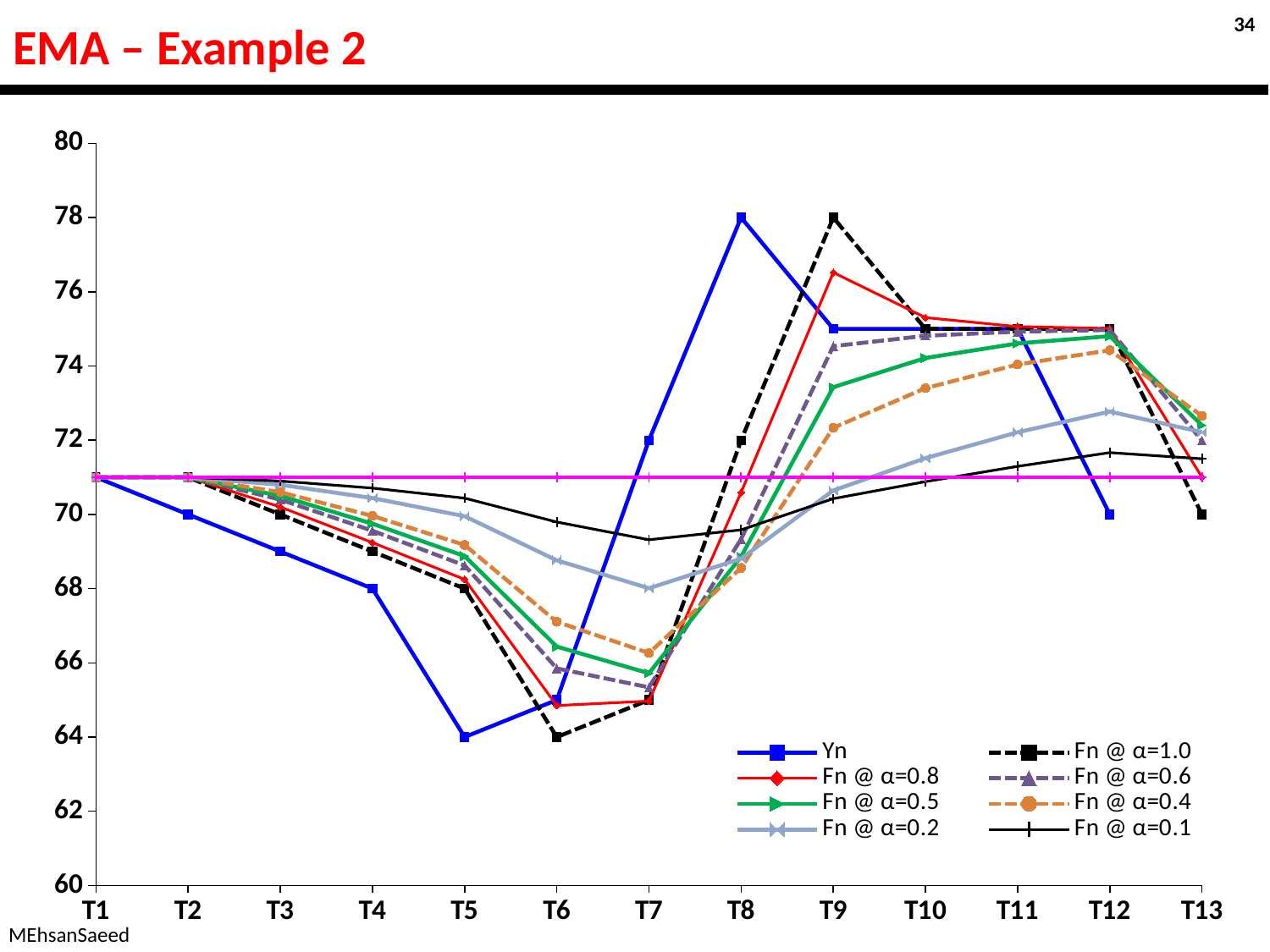
What is the value of Fn @ α=1.0 at T9? 78 What is the value of Yn at T8? 78 What is the value of Yn at T5? 64 What kind of chart is shown on the slide? line chart At T9, which is larger: Yn or Fn @ α=1.0? Fn @ α=1.0 How many time periods are shown on the x axis? 13 Is the value of Fn @ α=0.1 at T7 greater or less than 70? less How many series does the legend list? 8 At which time period does Yn reach its lowest value? T5 What is the difference between the Yn value at T8 and the Yn value at T5? 14 At which time period does Yn reach its highest value? T8 What is the value of Yn at T12? 70